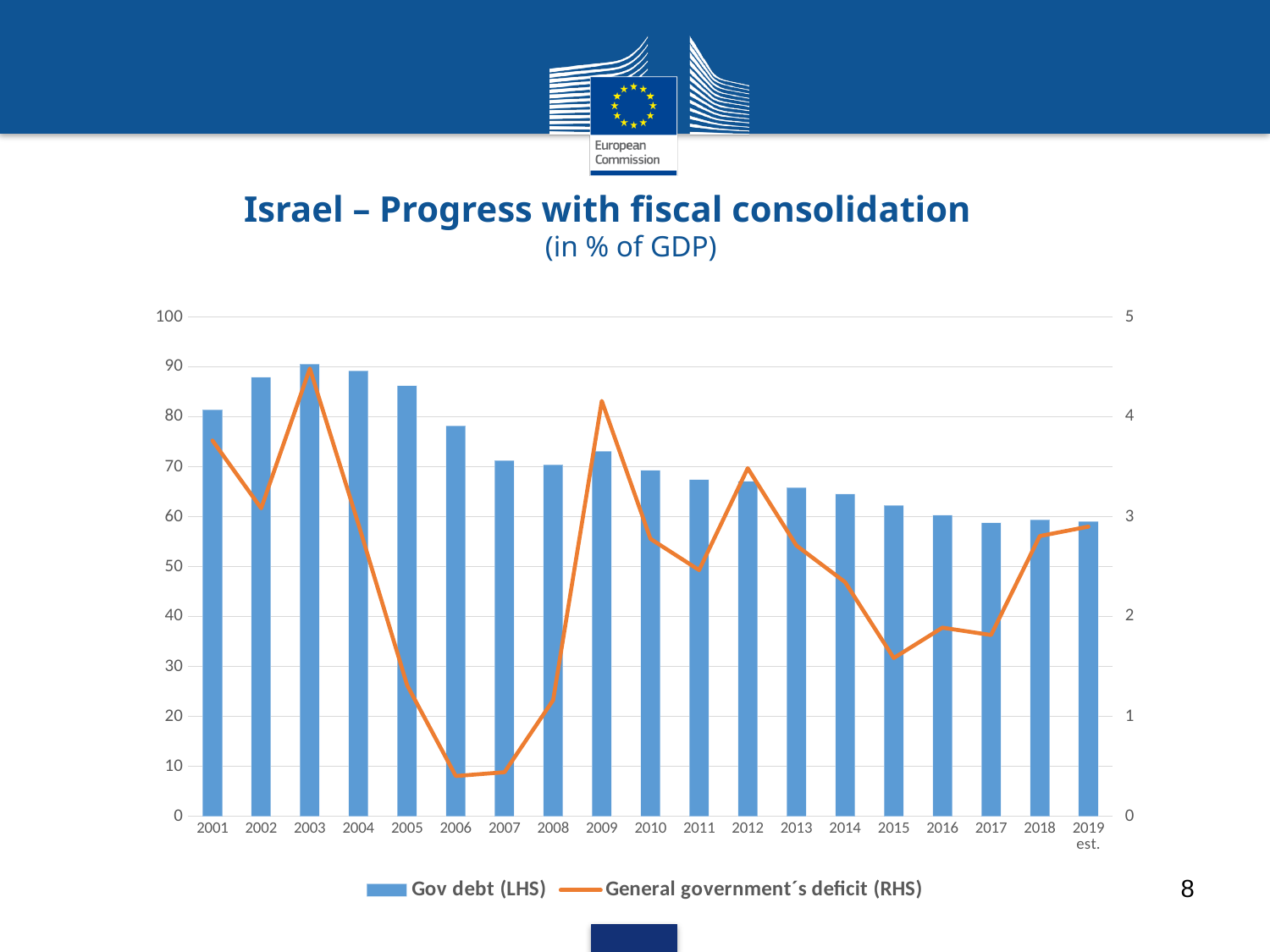
Is the General government's deficit value for 2009 greater or less than 4? greater How many years are shown on the x axis? 19 Which series is drawn as an orange line? General government's deficit (RHS) Does Gov debt rise or fall from 2010 to 2019? Fall Is the Gov debt value for 2001 greater or less than 80? greater What kind of chart is shown on the slide? A combined bar and line chart Is the General government's deficit value for 2006 greater or less than 1? less How many series does the legend list? 2 In which year is Gov debt (LHS) highest? 2003 In which year does the General government's deficit (RHS) line reach its highest point? 2003 Which year has the larger Gov debt, 2002 or 2007? 2002